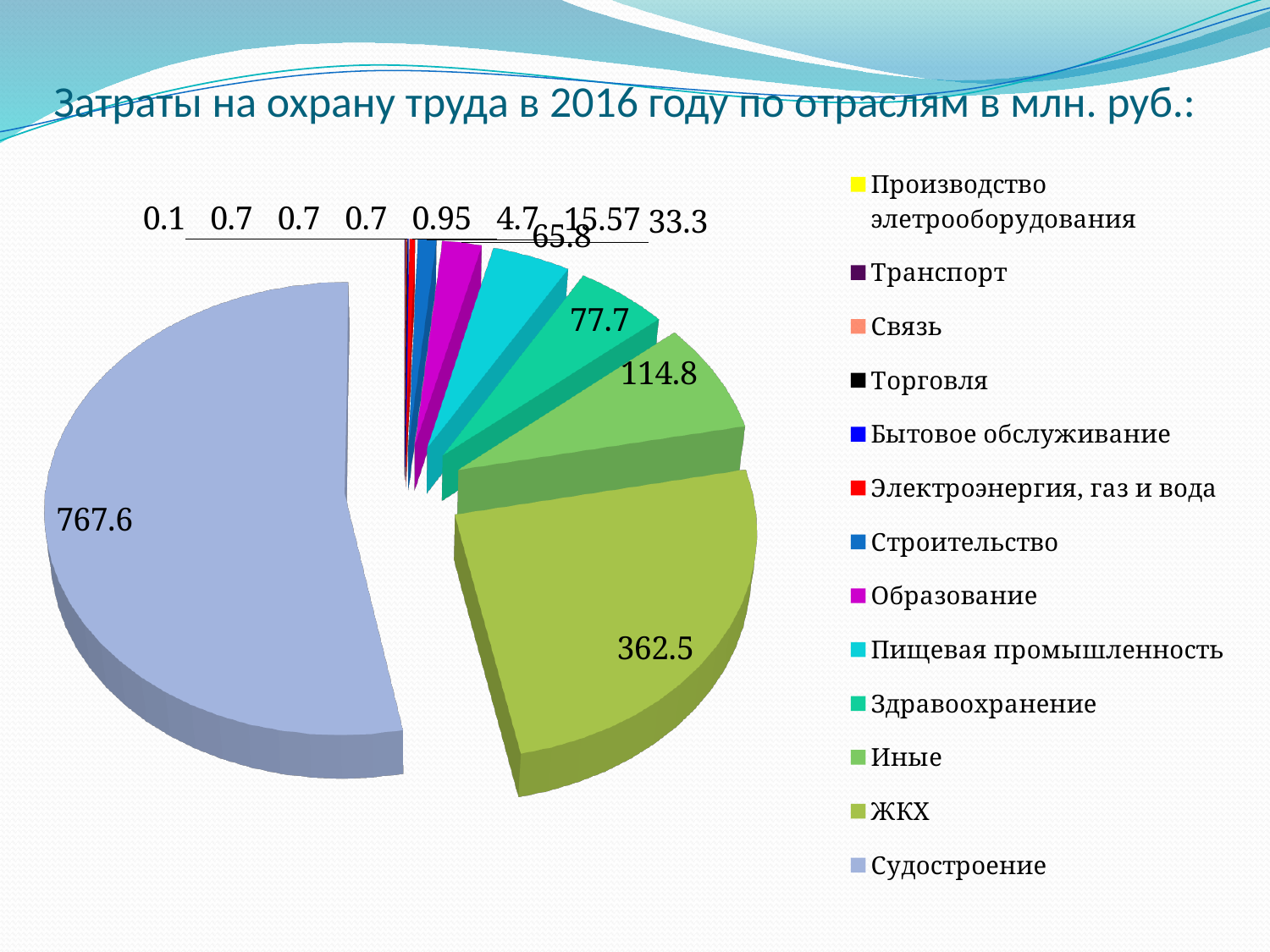
What kind of chart is shown on the slide? Pie chart Which industry has the largest slice of the pie? Судостроение What is the value shown for Образование? 33.3 What is the title of the chart? Затраты на охрану труда в 2016 году по отраслям в млн. руб.: What is the difference between the values for Судостроение and ЖКХ? 405.1 Which is larger, the value for Иные or the value for Здравоохранение? Иные What is the value shown for Пищевая промышленность? 65.8 What is the value shown for Иные? 114.8 What is the value shown for Судостроение? 767.6 How many categories does the legend list? 13 What is the value shown for ЖКХ? 362.5 What is the value shown for Здравоохранение? 77.7